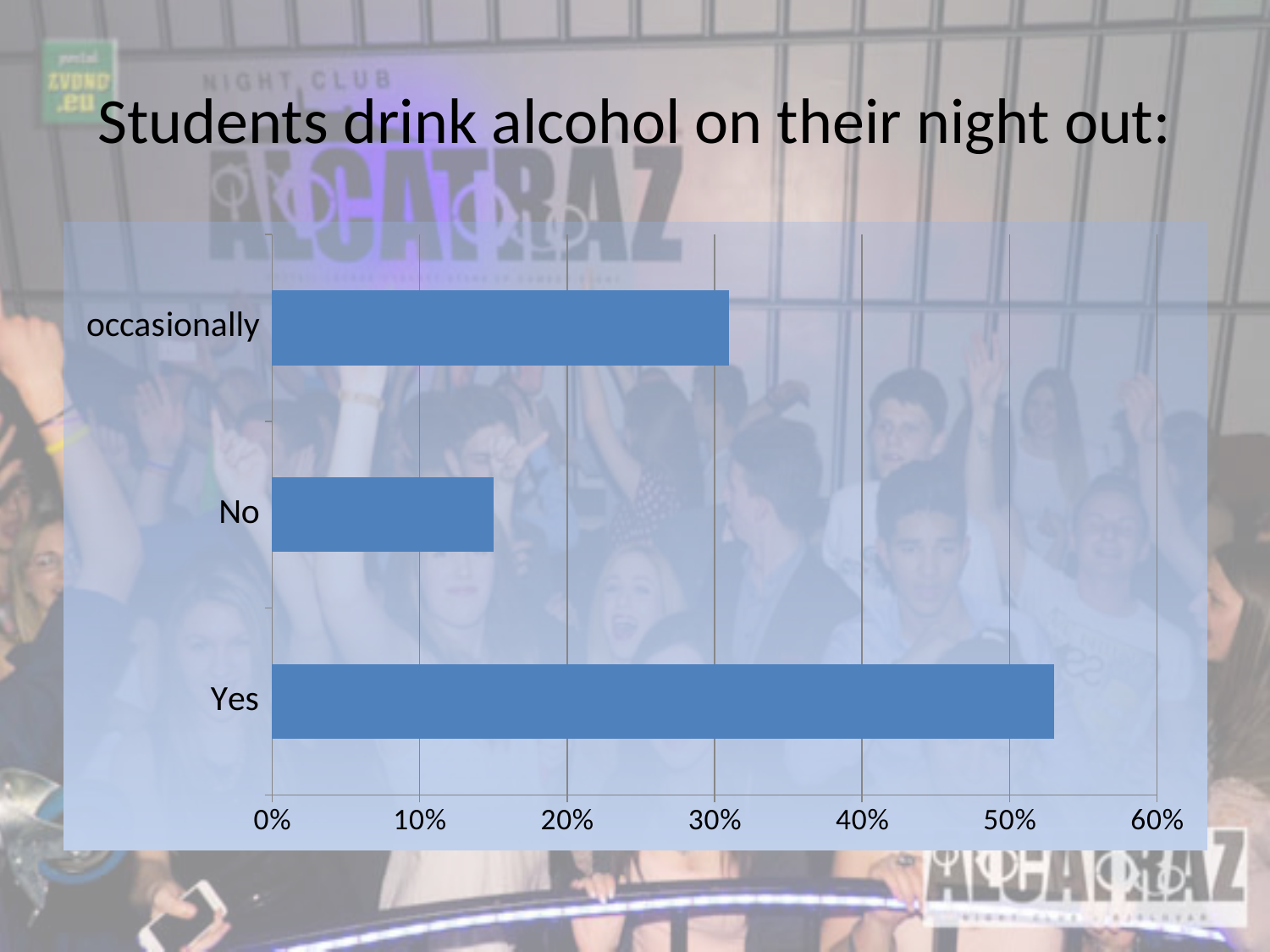
Which category has the lowest value? No Is the value for 'No' greater or less than 20%? less What is the title of the slide above the chart? Students drink alcohol on their night out: Is the value for 'occasionally' greater or less than 40%? less What kind of chart is shown on the slide? bar chart What is the highest value shown on the horizontal axis? 60% How many categories are plotted in the chart? 3 Is the value for 'Yes' greater or less than 50%? greater Which category has the highest value? Yes Which is larger, the value for 'Yes' or the value for 'occasionally'? Yes Which is larger, the value for 'occasionally' or the value for 'No'? occasionally